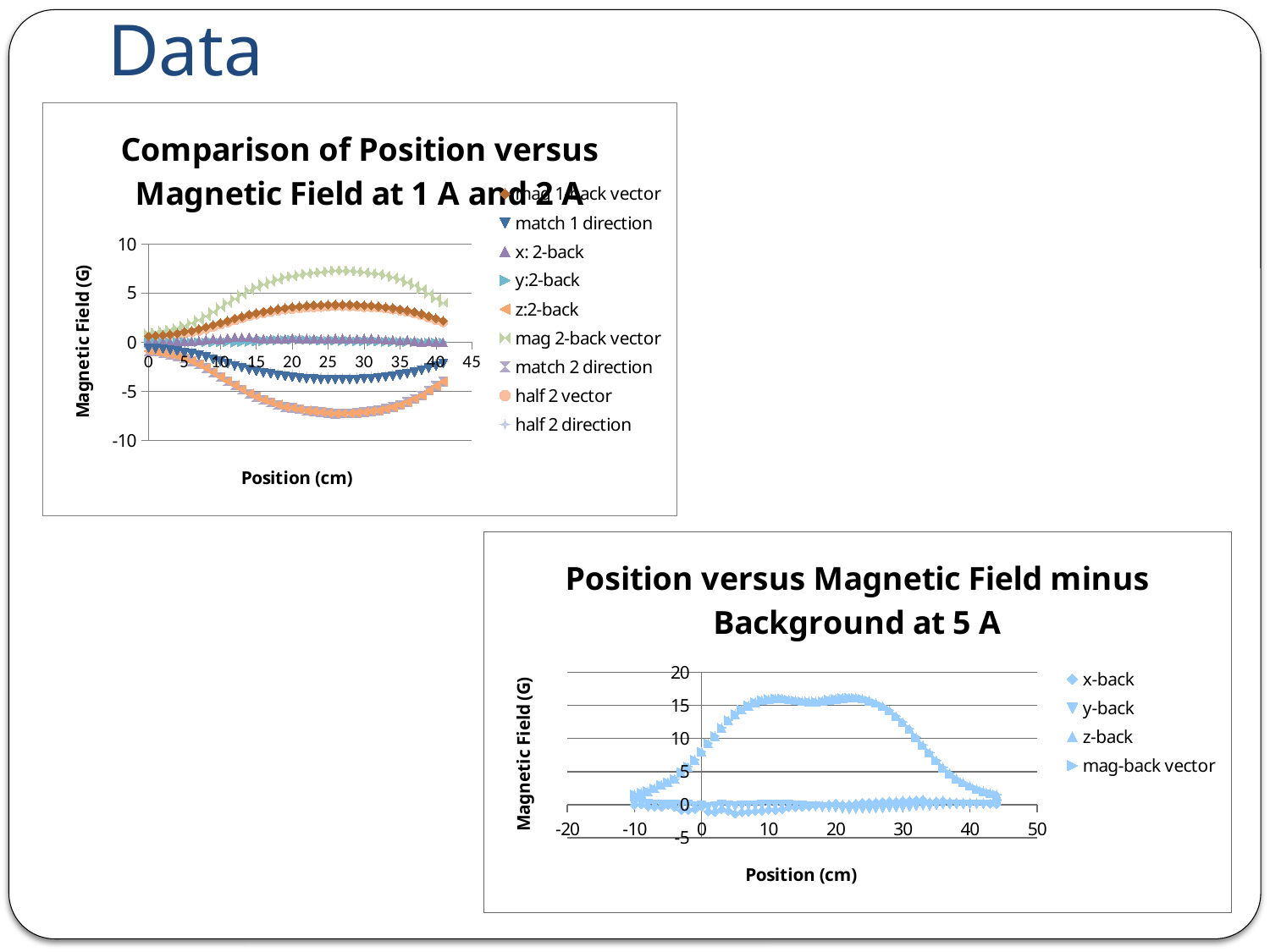
In the 'Position versus Magnetic Field minus Background at 5 A' chart, how does the 'mag-back vector' series change as position increases from -10 cm to 45 cm? rises, plateaus, then falls How many series does the legend of the 'Comparison of Position versus Magnetic Field at 1 A and 2 A' chart list? 9 What type of chart is the 'Comparison of Position versus Magnetic Field at 1 A and 2 A' chart? scatter chart How many series does the legend of the 'Position versus Magnetic Field minus Background at 5 A' chart list? 4 In the 'Comparison of Position versus Magnetic Field at 1 A and 2 A' chart, which series reaches a higher value at position 25 cm: 'mag 2-back vector' or 'mag 1-back vector'? mag 2-back vector In the 'Position versus Magnetic Field minus Background at 5 A' chart, what is the maximum value shown on the y-axis? 20 What is the y-axis title of the 'Position versus Magnetic Field minus Background at 5 A' chart? Magnetic Field (G) What is the x-axis title of the 'Comparison of Position versus Magnetic Field at 1 A and 2 A' chart? Position (cm) In the 'Comparison of Position versus Magnetic Field at 1 A and 2 A' chart, is the peak value of the 'mag 1-back vector' series greater or less than 5? less In the 'Comparison of Position versus Magnetic Field at 1 A and 2 A' chart, is the peak value of the 'mag 2-back vector' series greater or less than 5? greater In the 'Position versus Magnetic Field minus Background at 5 A' chart, is the highest value of the 'mag-back vector' series greater or less than 10? greater